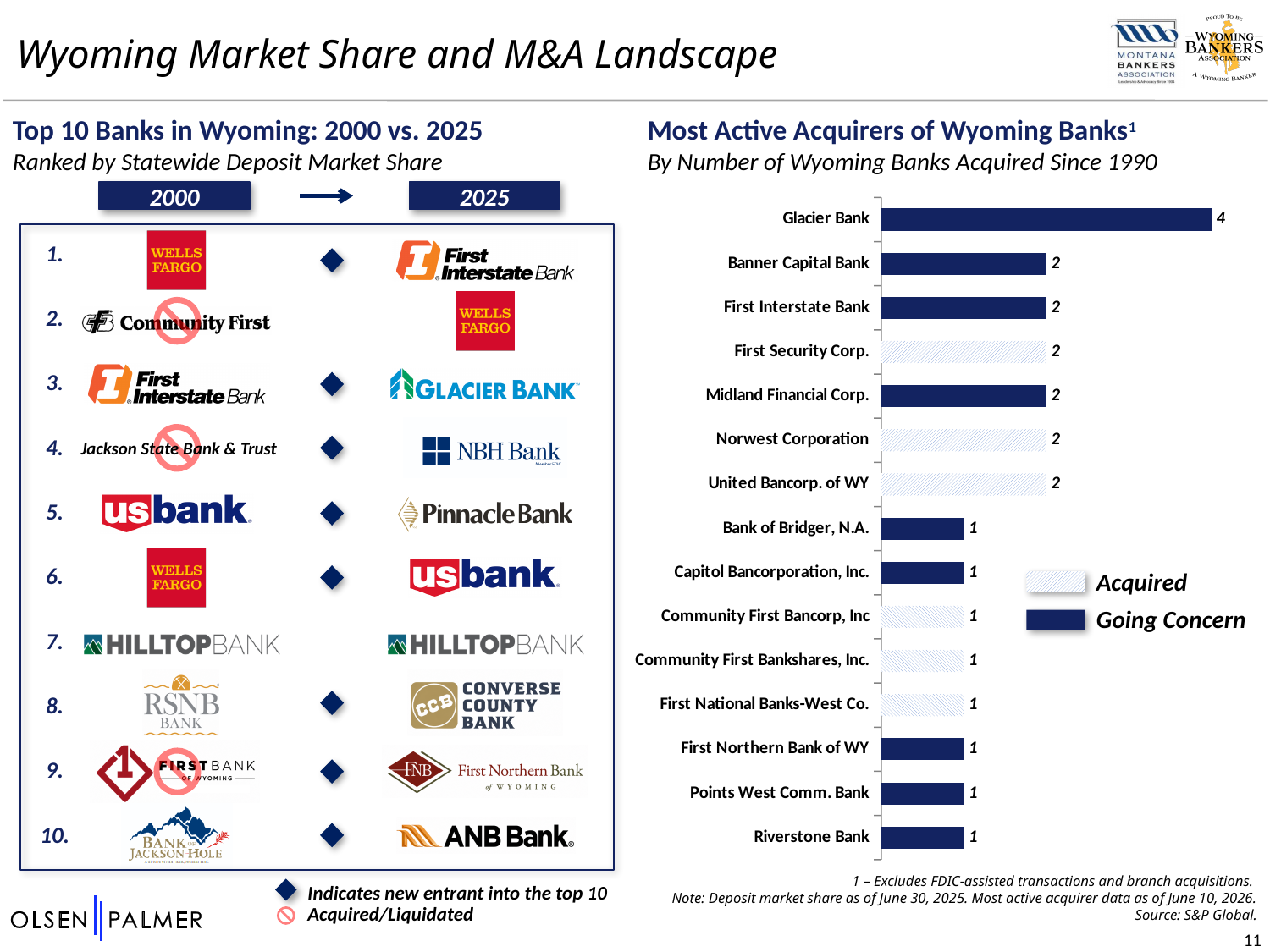
In the 'Most Active Acquirers of Wyoming Banks' chart, how many Wyoming banks has Glacier Bank acquired since 1990? 4 In the 'Most Active Acquirers of Wyoming Banks' chart, what is the value for Riverstone Bank? 1 How many acquirers are listed in the 'Most Active Acquirers of Wyoming Banks' chart? 15 In the 'Most Active Acquirers of Wyoming Banks' chart, which is larger: the value for Norwest Corporation or the value for Bank of Bridger, N.A.? Norwest Corporation What type of chart is the 'Most Active Acquirers of Wyoming Banks' chart? Bar chart What are the two legend entries in the 'Most Active Acquirers of Wyoming Banks' chart? Acquired and Going Concern In the 'Most Active Acquirers of Wyoming Banks' chart, what is the value for Midland Financial Corp.? 2 In the 'Most Active Acquirers of Wyoming Banks' chart, which acquirer has the highest number of Wyoming banks acquired? Glacier Bank In the 'Most Active Acquirers of Wyoming Banks' chart, what is the difference between the values for Glacier Bank and Points West Comm. Bank? 3 In the 'Most Active Acquirers of Wyoming Banks' chart, what is the difference between the values for Glacier Bank and First Interstate Bank? 2 How many entries does the legend of the 'Most Active Acquirers of Wyoming Banks' chart list? 2 In the 'Most Active Acquirers of Wyoming Banks' chart, what is the value for Banner Capital Bank? 2